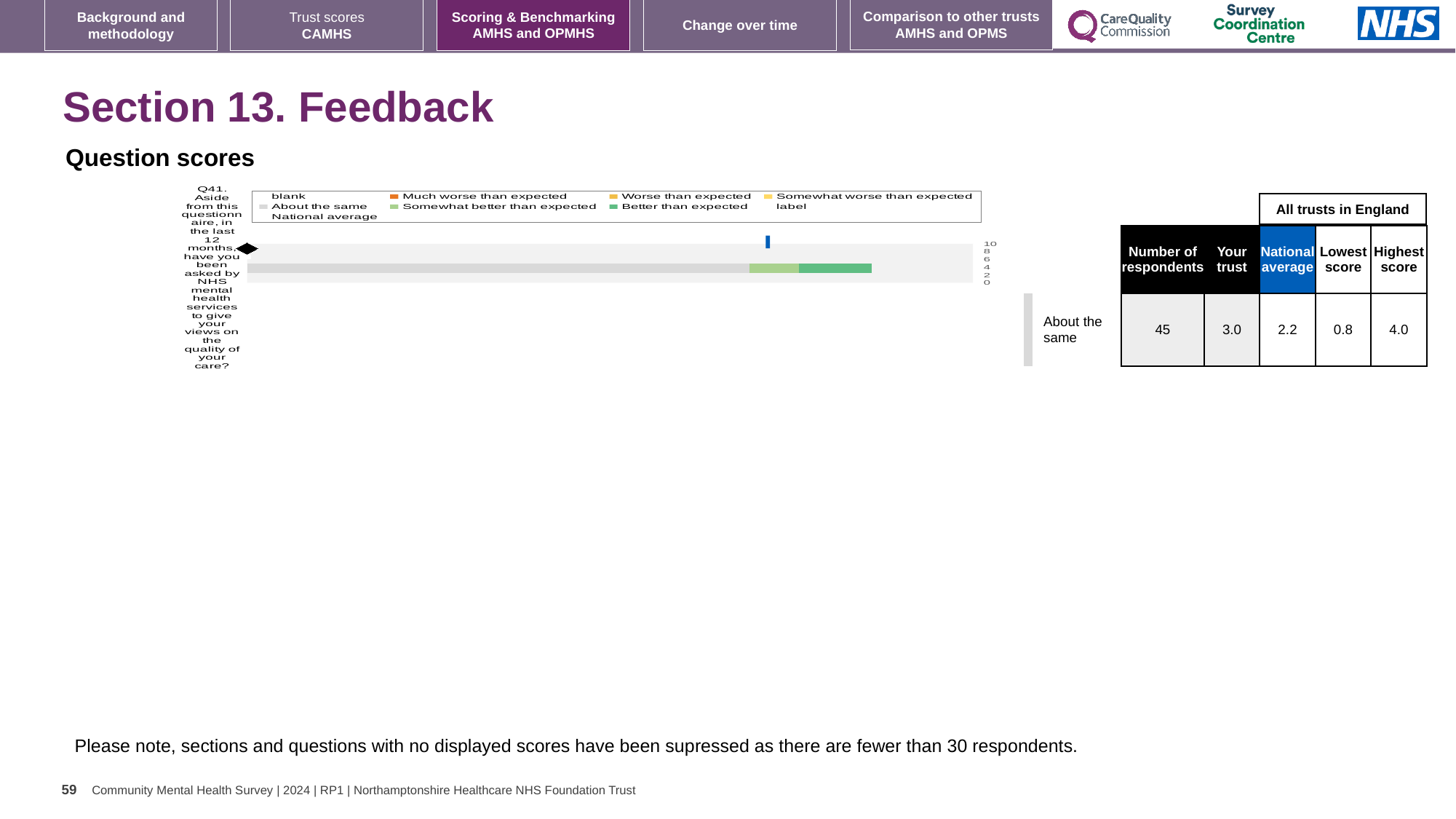
What is the lowest score among all trusts in England for Q41? 0.8 Which benchmark category is shown for Q41 in the Question scores chart? About the same How many respondents answered Q41? 45 What is the national average score for Q41? 2.2 What is the 'Your trust' score for Q41 in the Question scores chart? 3.0 How many survey questions are plotted in the Question scores chart? 1 Is the 'Your trust' score for Q41 greater or less than 2? greater For Q41, which is larger: the 'Your trust' score or the national average? Your trust What kind of chart is used to show the Q41 question score? Bar chart What is the difference between the highest score and the lowest score for Q41? 3.2 By how much does the 'Your trust' score for Q41 exceed the national average? 0.8 What is the highest score among all trusts in England for Q41? 4.0